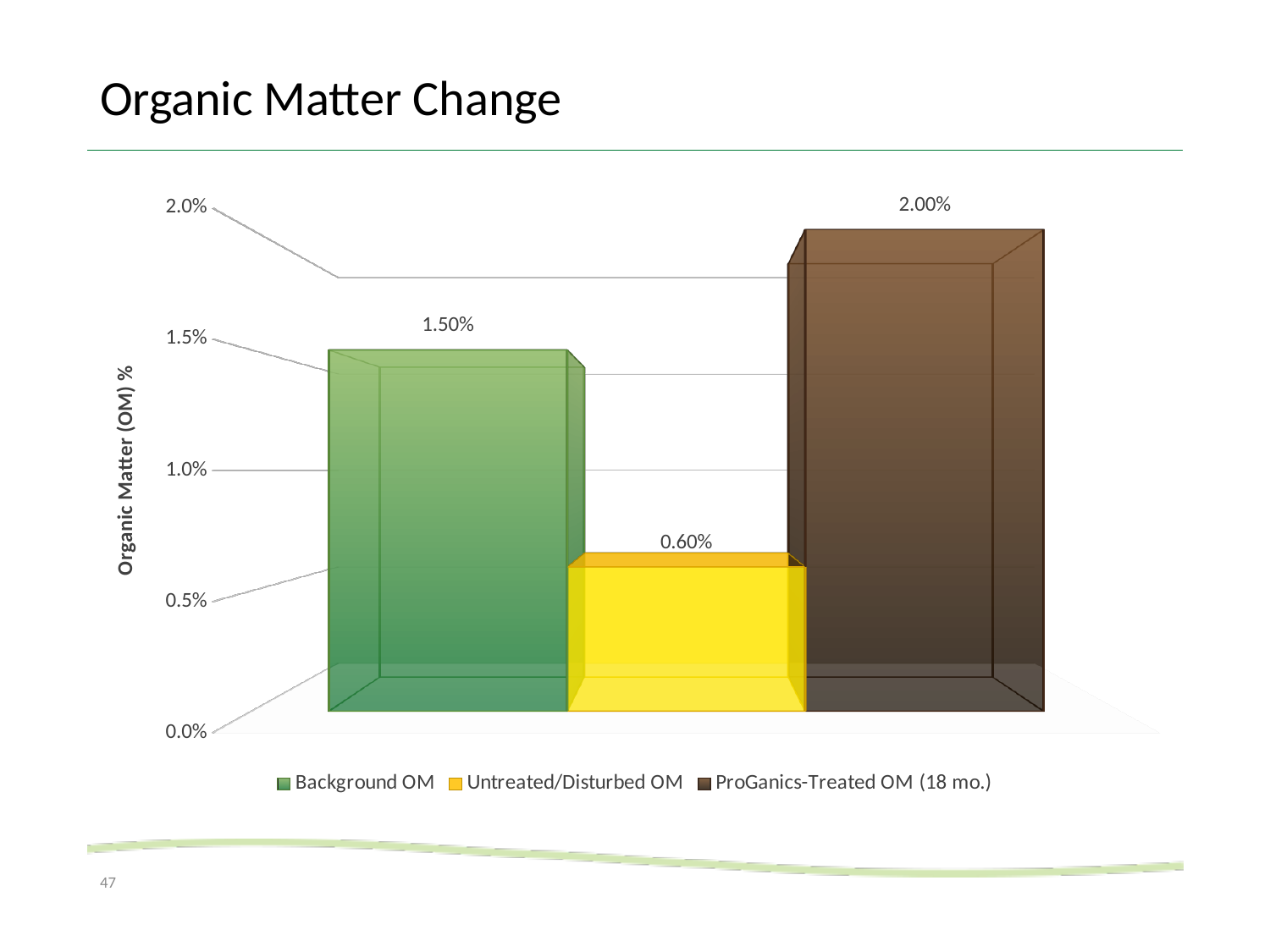
What is the value for Untreated/Disturbed OM? 0.60% Which series has the lowest organic matter value? Untreated/Disturbed OM What kind of chart is shown on the slide? bar chart What is the difference between the Background OM value and the Untreated/Disturbed OM value? 0.90% Which series has the highest organic matter value? ProGanics-Treated OM (18 mo.) How many series does the legend list? 3 What is the title of the chart? Organic Matter Change What is the value for Background OM? 1.50% What is the difference between the ProGanics-Treated OM (18 mo.) value and the Untreated/Disturbed OM value? 1.40% Is the value for Untreated/Disturbed OM greater or less than 1.0%? less What is the value for ProGanics-Treated OM (18 mo.)? 2.00% Which is larger, Background OM or ProGanics-Treated OM (18 mo.)? ProGanics-Treated OM (18 mo.)